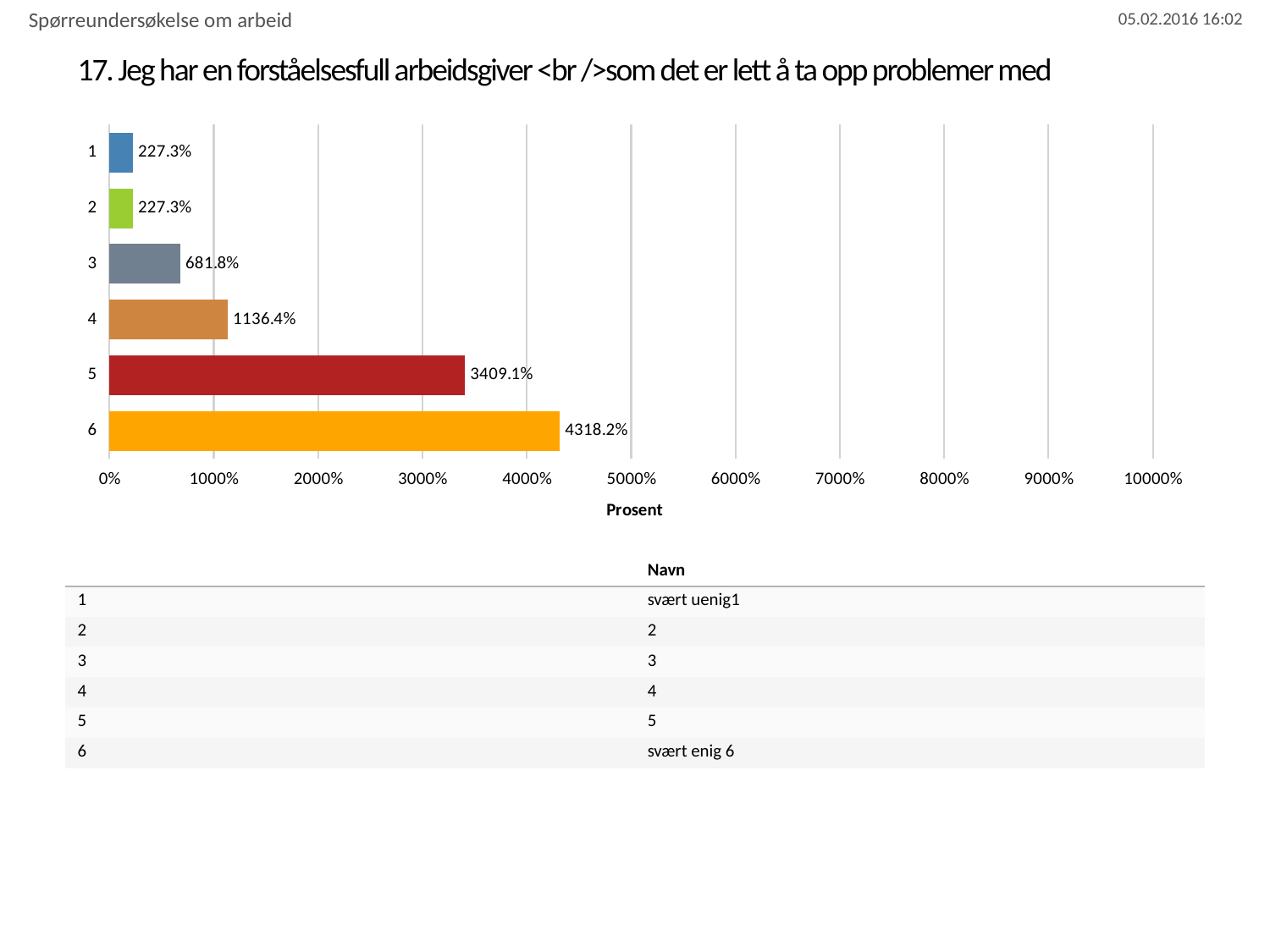
What is the label of the x axis? Prosent What is the value for category 4? 1136.4% Which category has the highest value? 6 What is the difference between the values for category 6 and category 5? 909.1% What is the value for category 6? 4318.2% Which is larger, the value for category 5 or the value for category 4? 5 What kind of chart is shown on the slide? bar chart What colour is the bar for category 6? yellow Is the value for category 5 greater or less than 3000%? greater What is the value for category 3? 681.8% What is the difference between the values for category 4 and category 3? 454.6% How many categories are shown in the chart? 6